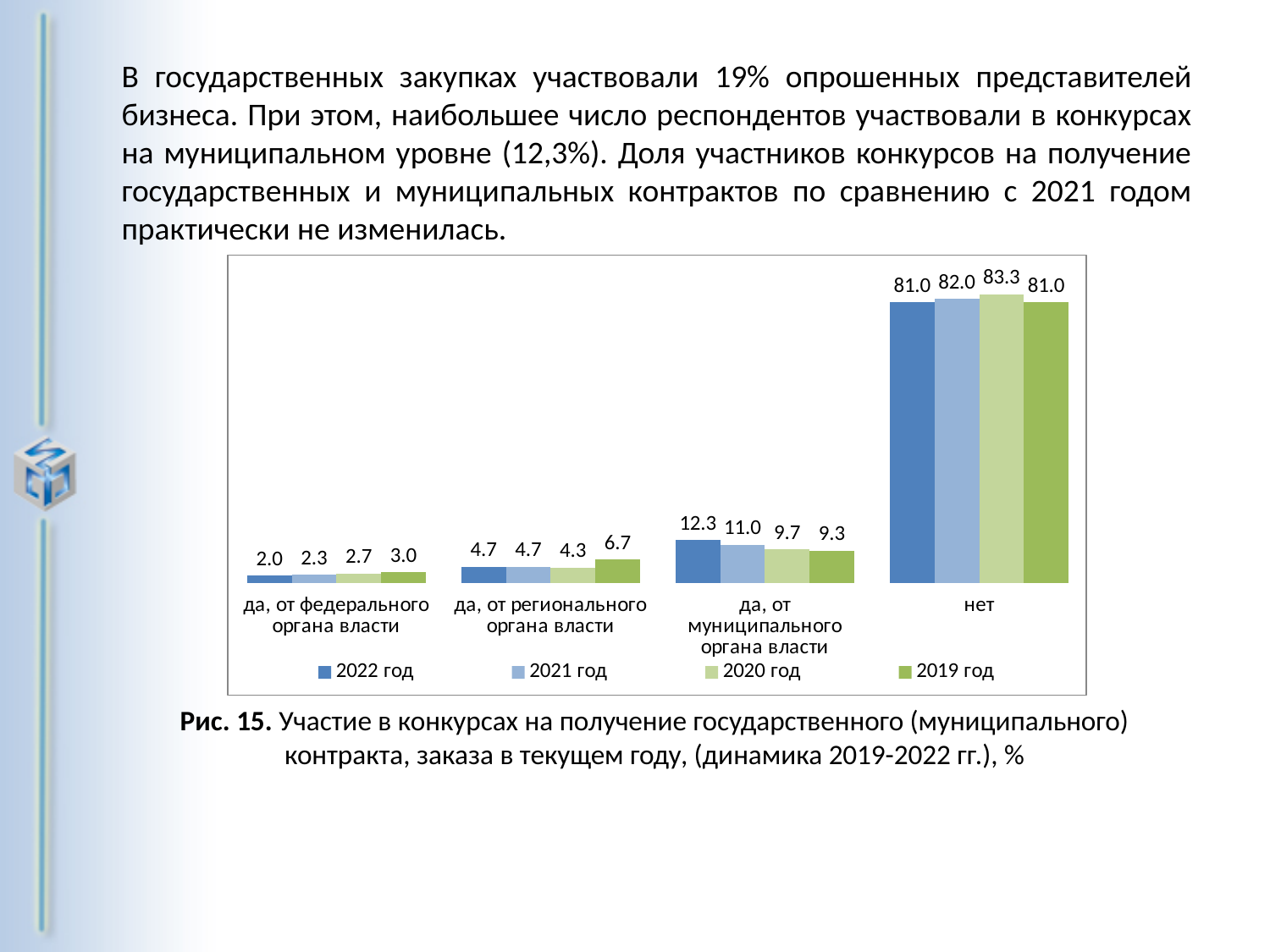
What is the value for "нет" in the 2020 год series? 83.3 Which category has the lowest value in the 2019 год series? да, от федерального органа власти What is the value for "да, от муниципального органа власти" in the 2022 год series? 12.3 Which is larger for "да, от регионального органа власти": the 2019 год value or the 2020 год value? 2019 год Do the values for "да, от федерального органа власти" rise or fall from the 2022 год series to the 2019 год series? rise Which category has the highest value in the 2022 год series? нет How many series does the legend list? 4 What is the difference between the 2022 год and 2019 год values for "да, от муниципального органа власти"? 3.0 How many categories are shown on the x axis? 4 What is the value for "да, от федерального органа власти" in the 2021 год series? 2.3 What kind of chart is shown on the slide? bar chart What is the value for "да, от регионального органа власти" in the 2019 год series? 6.7